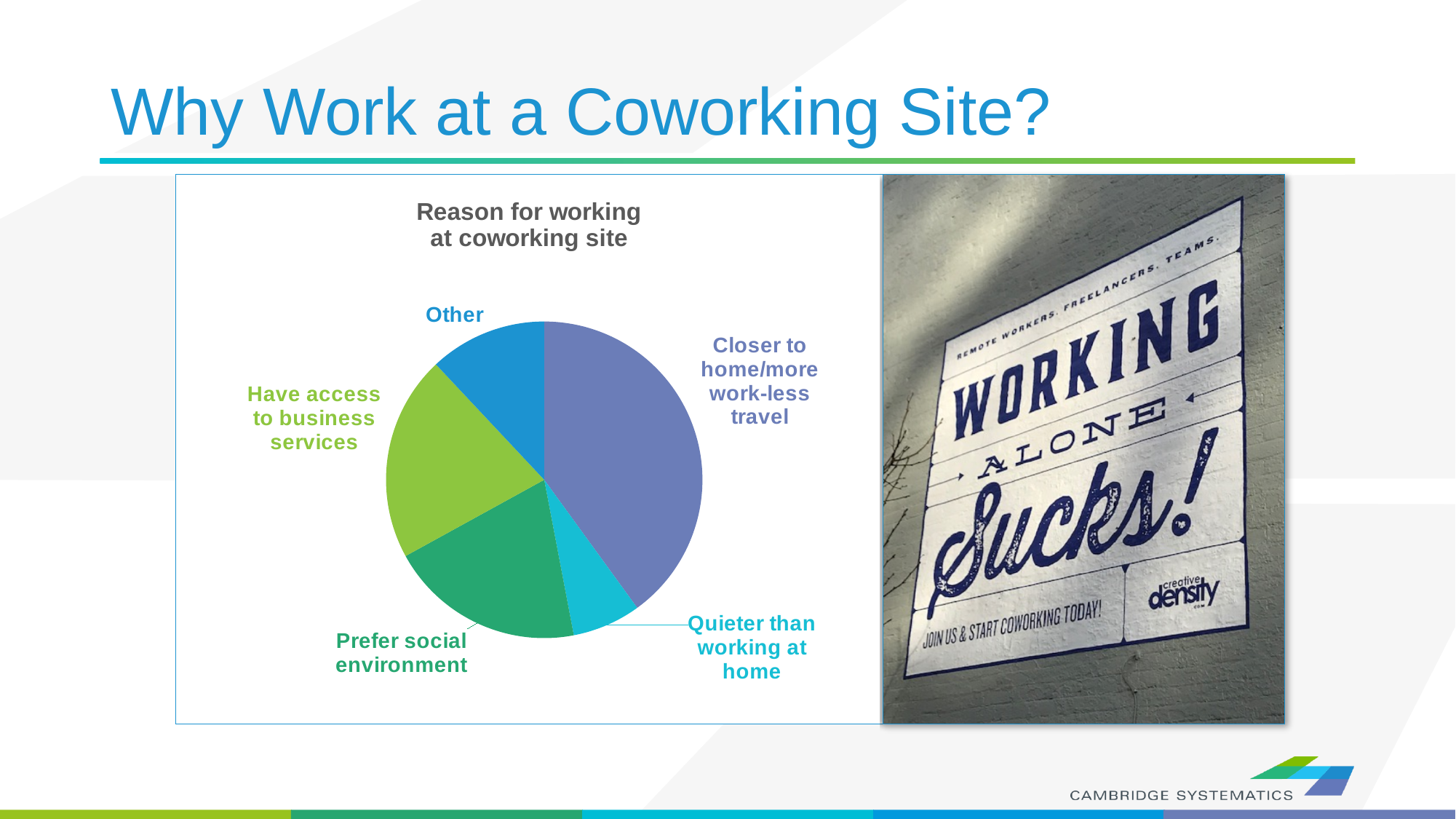
What colour is the "Have access to business services" slice? green Which slice is larger: "Prefer social environment" or "Other"? Prefer social environment What kind of chart is shown on the slide? pie chart Which slice is larger: "Have access to business services" or "Quieter than working at home"? Have access to business services Which reason has the largest slice of the pie? Closer to home/more work-less travel What is the title of the chart? Reason for working at coworking site Which slice is larger: "Other" or "Quieter than working at home"? Other Which reason has the smallest slice of the pie? Quieter than working at home How many categories (slices) does the pie chart have? 5